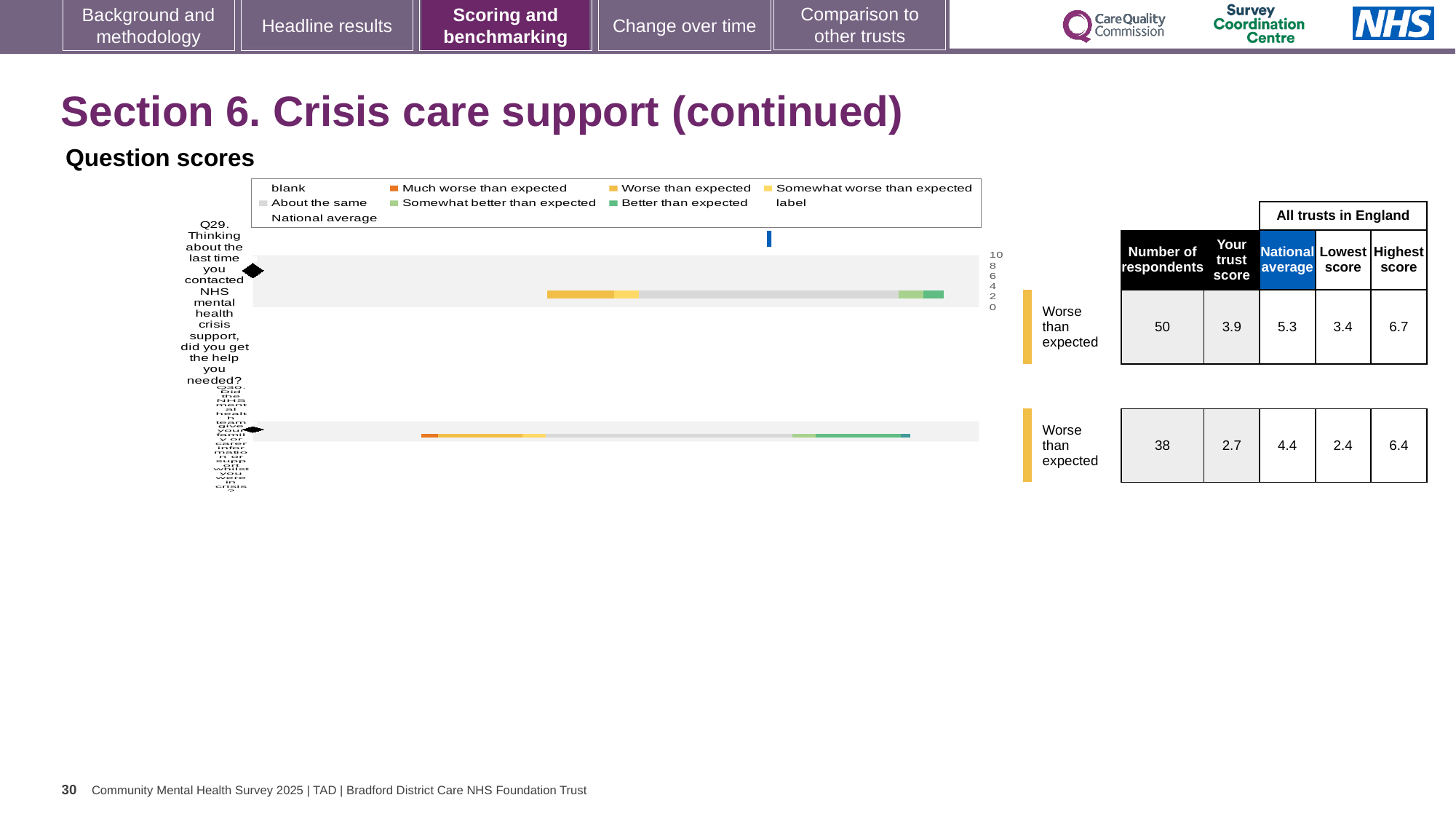
How many questions are plotted in the question scores chart? 2 What is the difference between the highest and lowest scores across all trusts in England for Q30? 4.0 What is the difference between the national average and the trust score for Q29? 1.4 What kind of chart is used to show the question scores on this slide? bar chart Which question has the higher trust score, Q29 or Q30? Q29 What is the national average score for Q29? 5.3 What is the trust score for Q30? 2.7 Is the trust score for Q30 greater or less than 4? less How many respondents answered Q30? 38 What benchmark category is shown for Q29? Worse than expected What is the highest score across all trusts in England for Q29? 6.7 What is the trust score for Q29 (Thinking about the last time you contacted NHS mental health crisis support, did you get the help you needed?)? 3.9